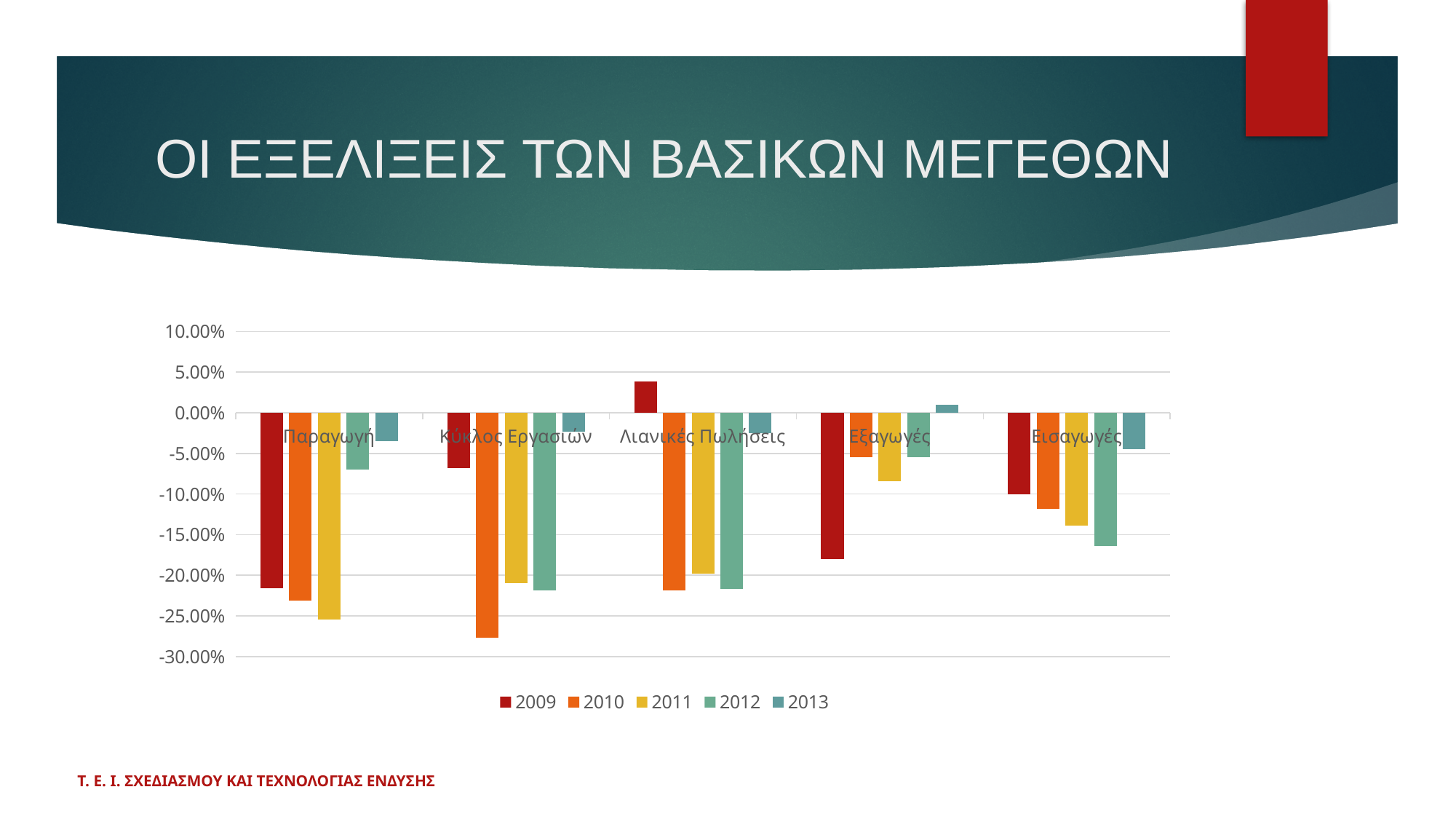
Is the 2012 value for Εισαγωγές greater or less than -15.00%? less What kind of chart is shown on the slide? bar chart Which years are listed in the chart legend? 2009, 2010, 2011, 2012, 2013 Is the 2010 value for Κύκλος Εργασιών greater or less than -25.00%? less How many categories are shown on the x axis of the chart? 5 Is the 2013 value for Εξαγωγές greater or less than 0.00%? greater Within the Παραγωγή category, which year has the lowest value? 2011 How many series does the chart legend list? 5 Which category and year has the highest value in the chart? Λιανικές Πωλήσεις, 2009 Which is larger, the 2009 value for Παραγωγή or the 2009 value for Εξαγωγές? Εξαγωγές Which category and year has the lowest value in the chart? Κύκλος Εργασιών, 2010